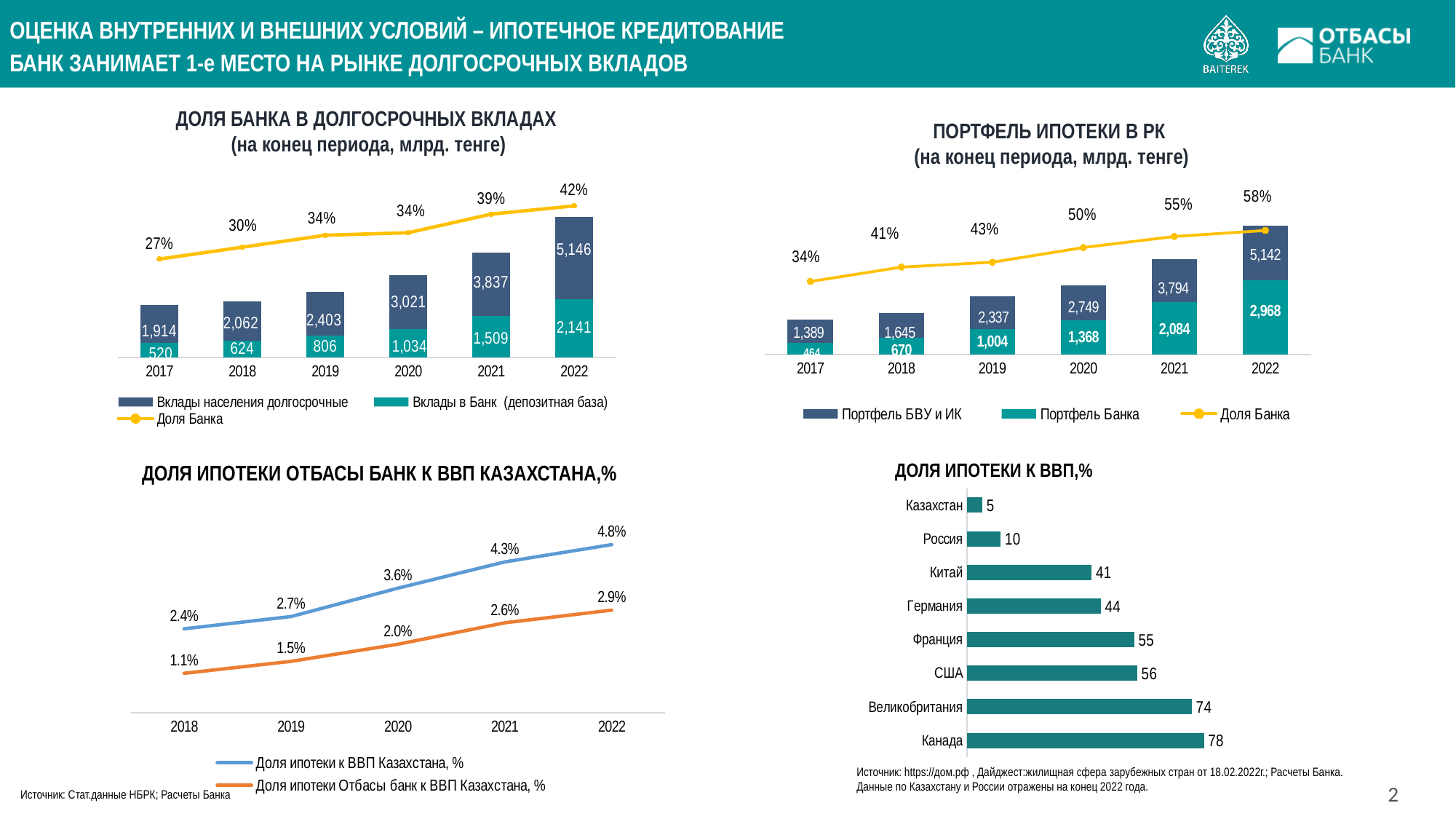
In the chart 'ПОРТФЕЛЬ ИПОТЕКИ В РК', what is the value of 'Портфель Банка' for 2021? 2,084 In the chart 'ПОРТФЕЛЬ ИПОТЕКИ В РК', what is the difference between 'Портфель БВУ и ИК' and 'Портфель Банка' in 2022? 2,174 In the chart 'ДОЛЯ ИПОТЕКИ ОТБАСЫ БАНК К ВВП КАЗАХСТАНА,%', how many years are shown on the x axis? 5 In the chart 'ДОЛЯ ИПОТЕКИ К ВВП,%', which country has the lowest value? Казахстан In the chart 'ДОЛЯ ИПОТЕКИ К ВВП,%', which is larger: the value for Китай or the value for Германия? Германия What kind of chart is 'ДОЛЯ ИПОТЕКИ К ВВП,%'? bar chart In the chart 'ДОЛЯ БАНКА В ДОЛГОСРОЧНЫХ ВКЛАДАХ', what is the 'Доля Банка' value for 2017? 27% In the chart 'ПОРТФЕЛЬ ИПОТЕКИ В РК', does the 'Доля Банка' line rise or fall from 2017 to 2022? rise In the chart 'ДОЛЯ БАНКА В ДОЛГОСРОЧНЫХ ВКЛАДАХ', how many series does the legend list? 3 In the chart 'ДОЛЯ ИПОТЕКИ К ВВП,%', which country has the highest value? Канада In the chart 'ДОЛЯ ИПОТЕКИ ОТБАСЫ БАНК К ВВП КАЗАХСТАНА,%', what is the value of 'Доля ипотеки к ВВП Казахстана, %' for 2020? 3.6% In the chart 'ДОЛЯ БАНКА В ДОЛГОСРОЧНЫХ ВКЛАДАХ', what is the value of 'Вклады в Банк (депозитная база)' for 2022? 2,141